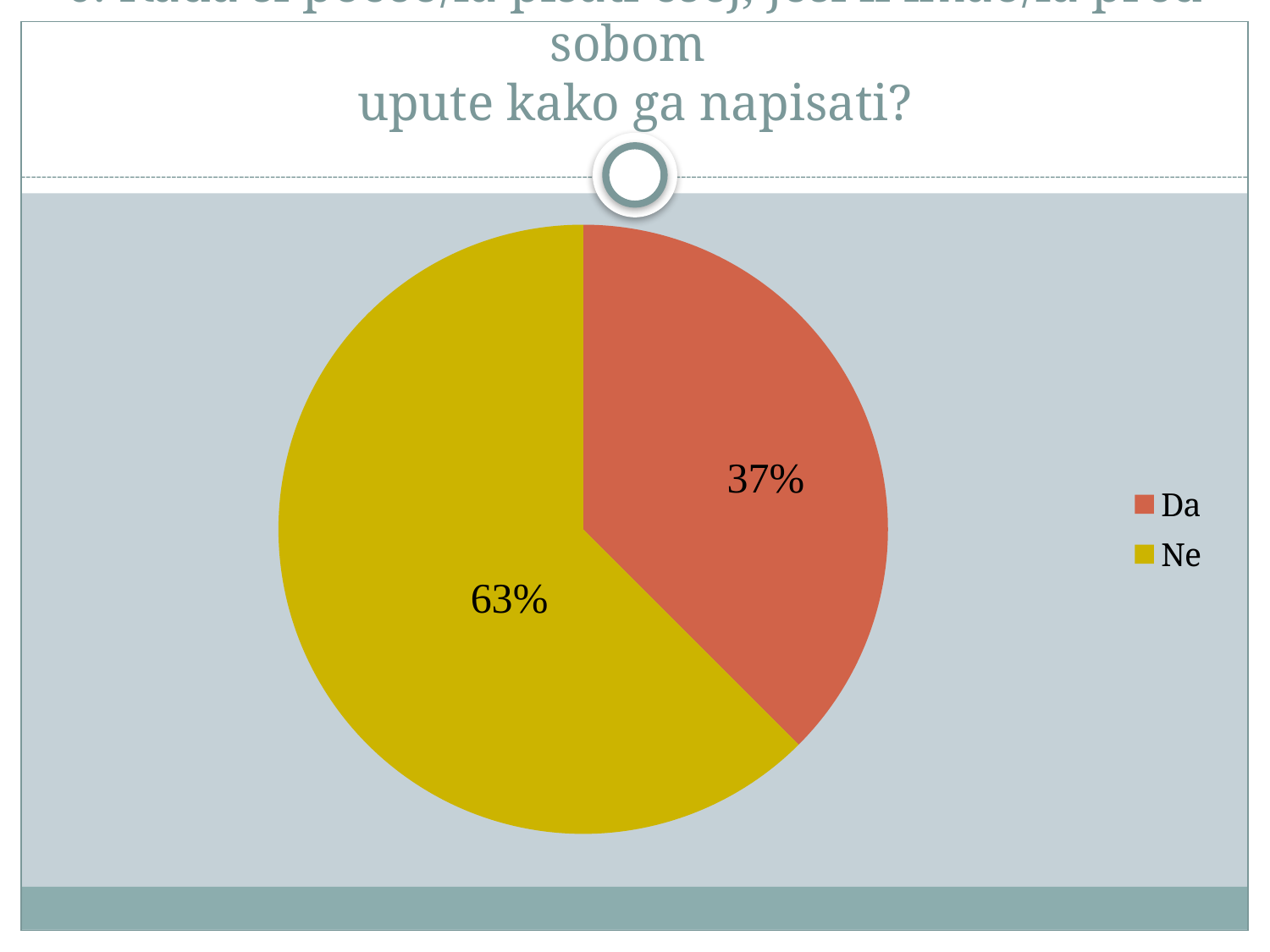
Which category has the largest slice of the pie? Ne How many slices does the pie chart have? 2 Which category has the smallest slice of the pie? Da What kind of chart is shown on the slide? Pie chart What share of the pie does "Da" represent? 37% What colour is the "Da" slice? Red What colour is the "Ne" slice? Yellow What share of the pie does "Ne" represent? 63% How many entries does the legend list? 2 Which slice is larger, "Da" or "Ne"? Ne What is the difference in percentage points between the "Ne" and "Da" slices? 26